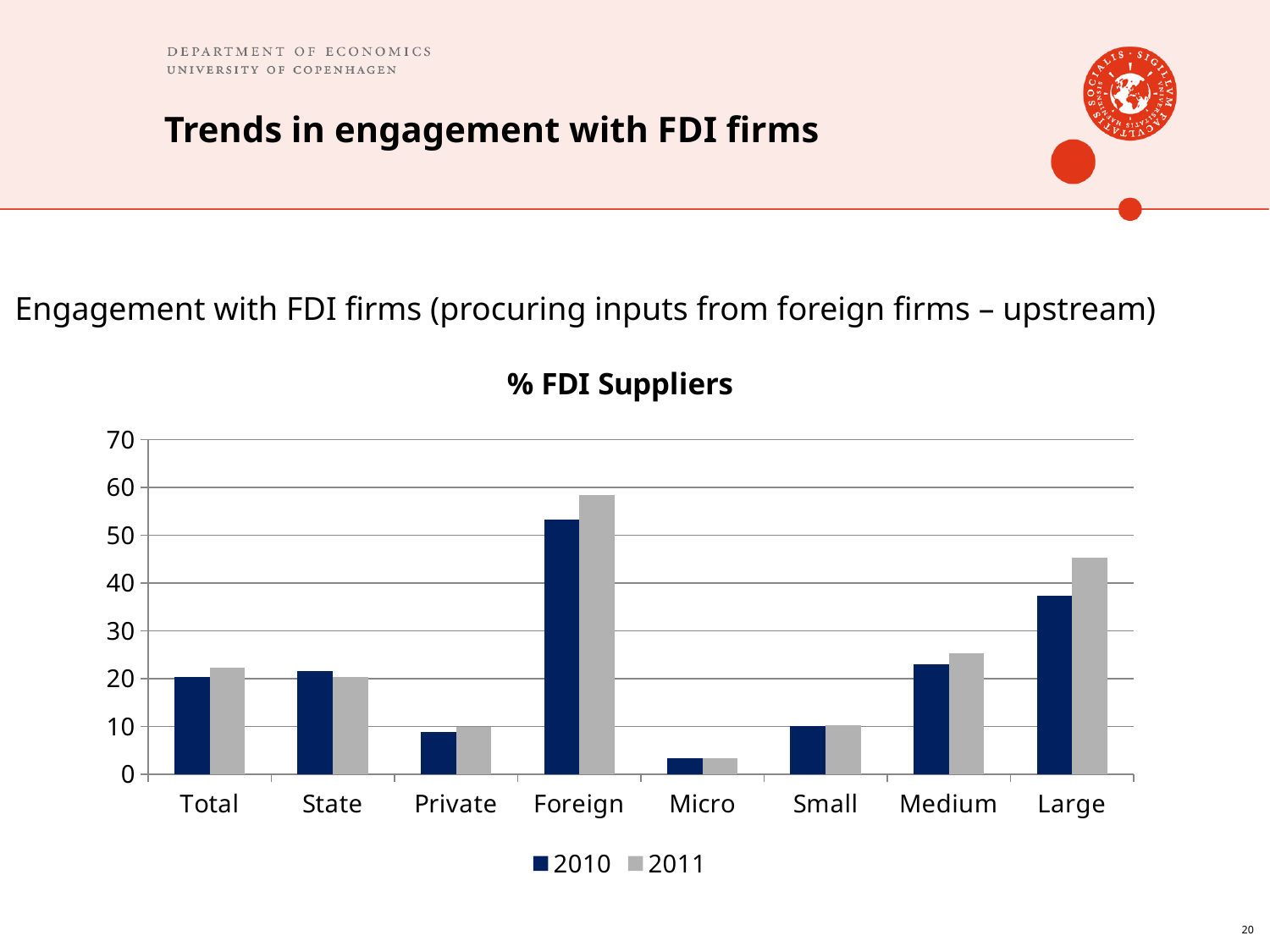
Is the 2011 value for Large greater or less than 40? greater What is the title of the chart? % FDI Suppliers How many series does the legend list? 2 Which category has the highest value for 2011? Foreign What type of chart is shown on the slide? bar chart Is the 2011 value for Medium greater or less than 20? greater Which series is shown in dark blue in the legend? 2010 For Large, which year has the larger value, 2010 or 2011? 2011 Is the 2010 value for Foreign greater or less than 50? greater Which category has the lowest value for 2010? Micro How many categories are shown on the x axis? 8